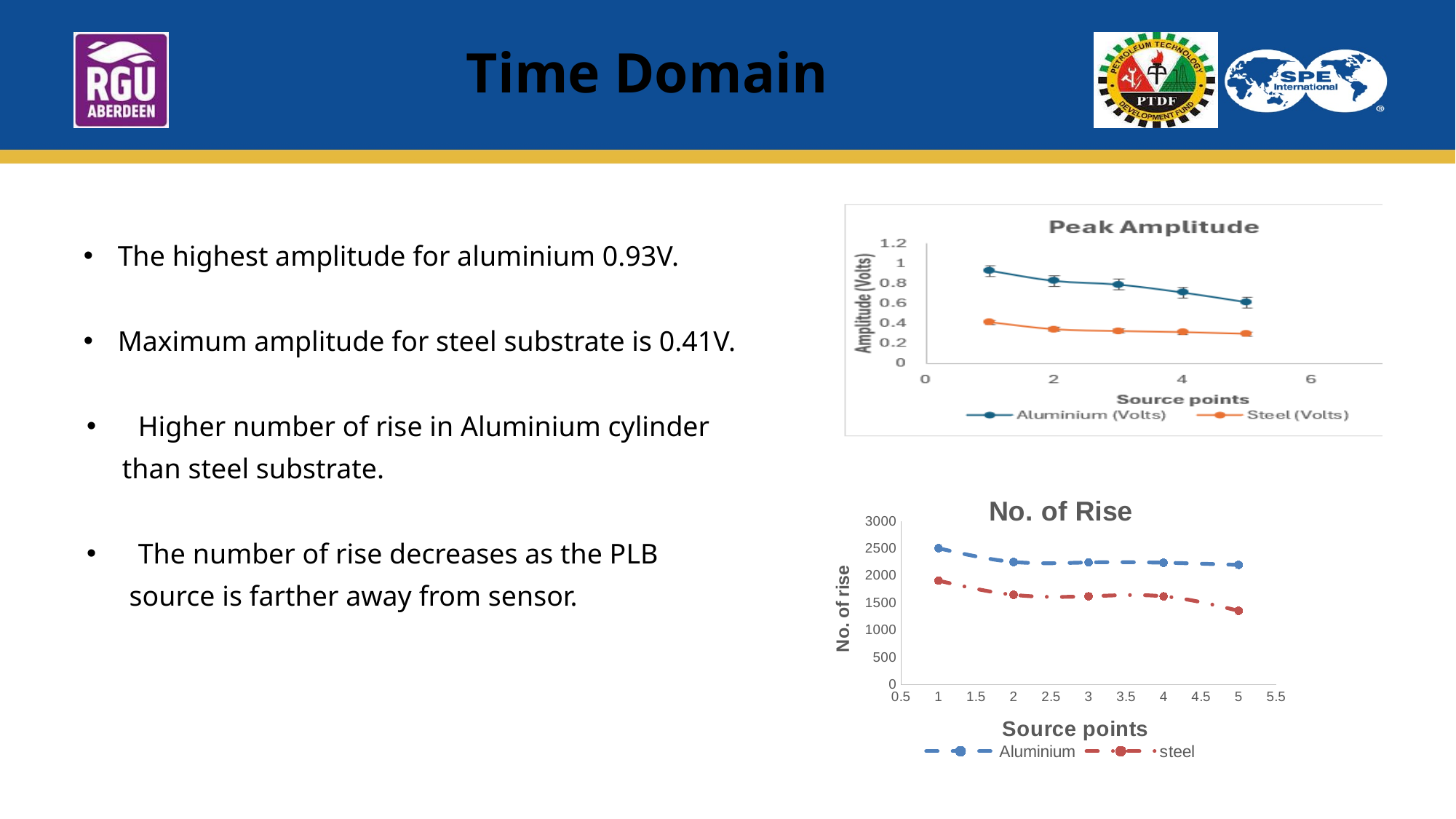
In the No. of Rise chart, at which source point is the steel value lowest? 5 In the Peak Amplitude chart, which series has the larger value at source point 3, Aluminium or Steel? Aluminium What kind of chart is the Peak Amplitude chart? line chart In the Peak Amplitude chart, is the Steel value at source point 5 greater or less than 0.4? less In the Peak Amplitude chart, how many source points are plotted for the Aluminium series? 5 How many series does the legend of the No. of Rise chart list? 2 In the No. of Rise chart, is the steel value at source point 5 greater or less than 1500? less In the Peak Amplitude chart, at which source point is the Aluminium (Volts) value lowest? 5 In the No. of Rise chart, is the Aluminium value at source point 1 greater or less than 2000? greater In the Peak Amplitude chart, at which source point is the Aluminium (Volts) value highest? 1 In the No. of Rise chart, do the Aluminium values rise or fall as the source point increases? fall